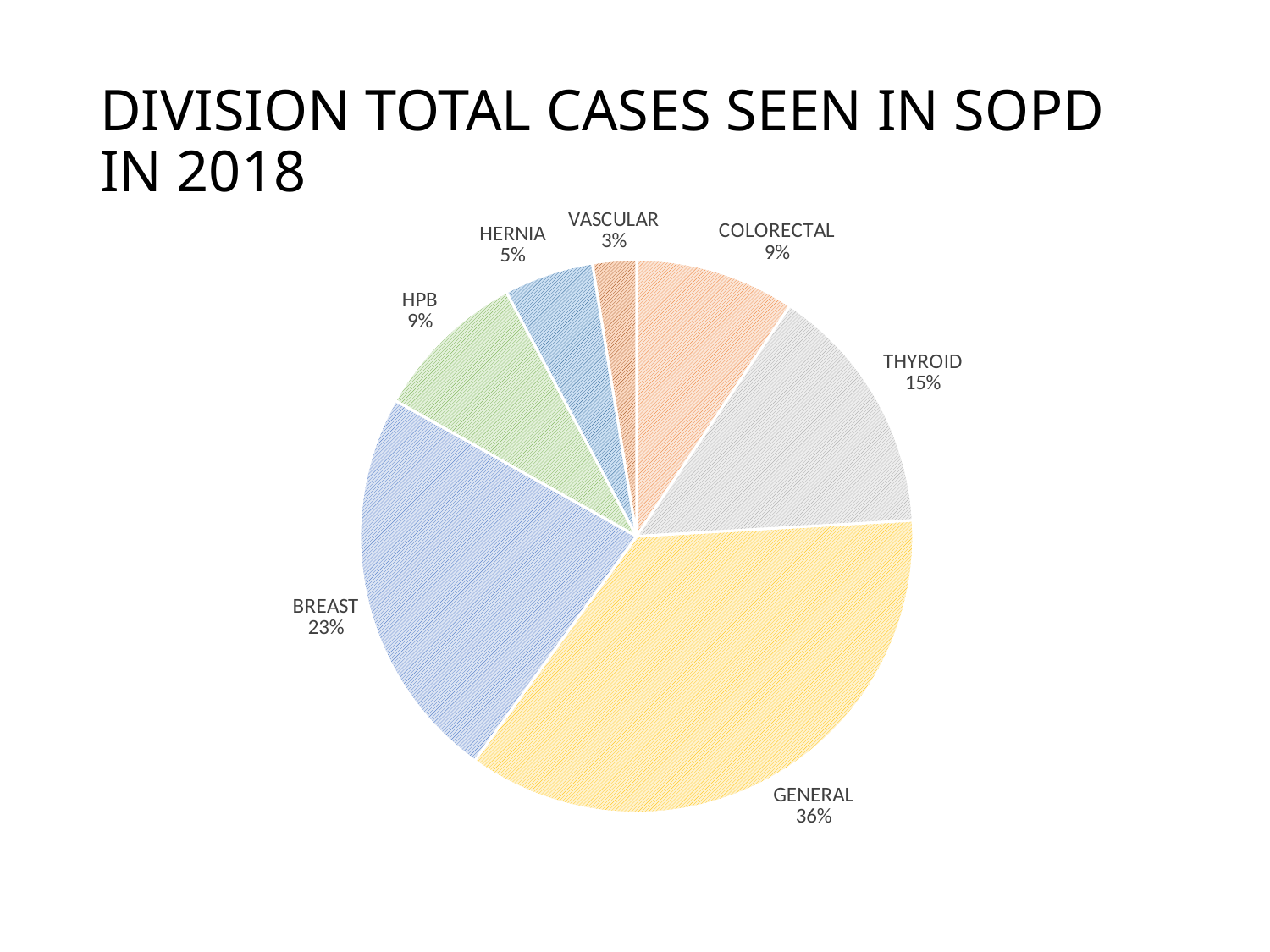
What percentage is shown for THYROID? 15% How many divisions are shown in the pie chart? 7 What percentage is shown for VASCULAR? 3% Which is larger, the share for THYROID or the share for HERNIA? THYROID Which division has the largest slice of the pie? GENERAL What share of the pie does GENERAL account for? 36% What kind of chart is shown on the slide? Pie chart Which two divisions each have a 9% share? COLORECTAL and HPB Which division has the smallest slice of the pie? VASCULAR What is the title of the slide? DIVISION TOTAL CASES SEEN IN SOPD IN 2018 What percentage is shown for BREAST? 23% What is the difference in percentage points between GENERAL and BREAST? 13